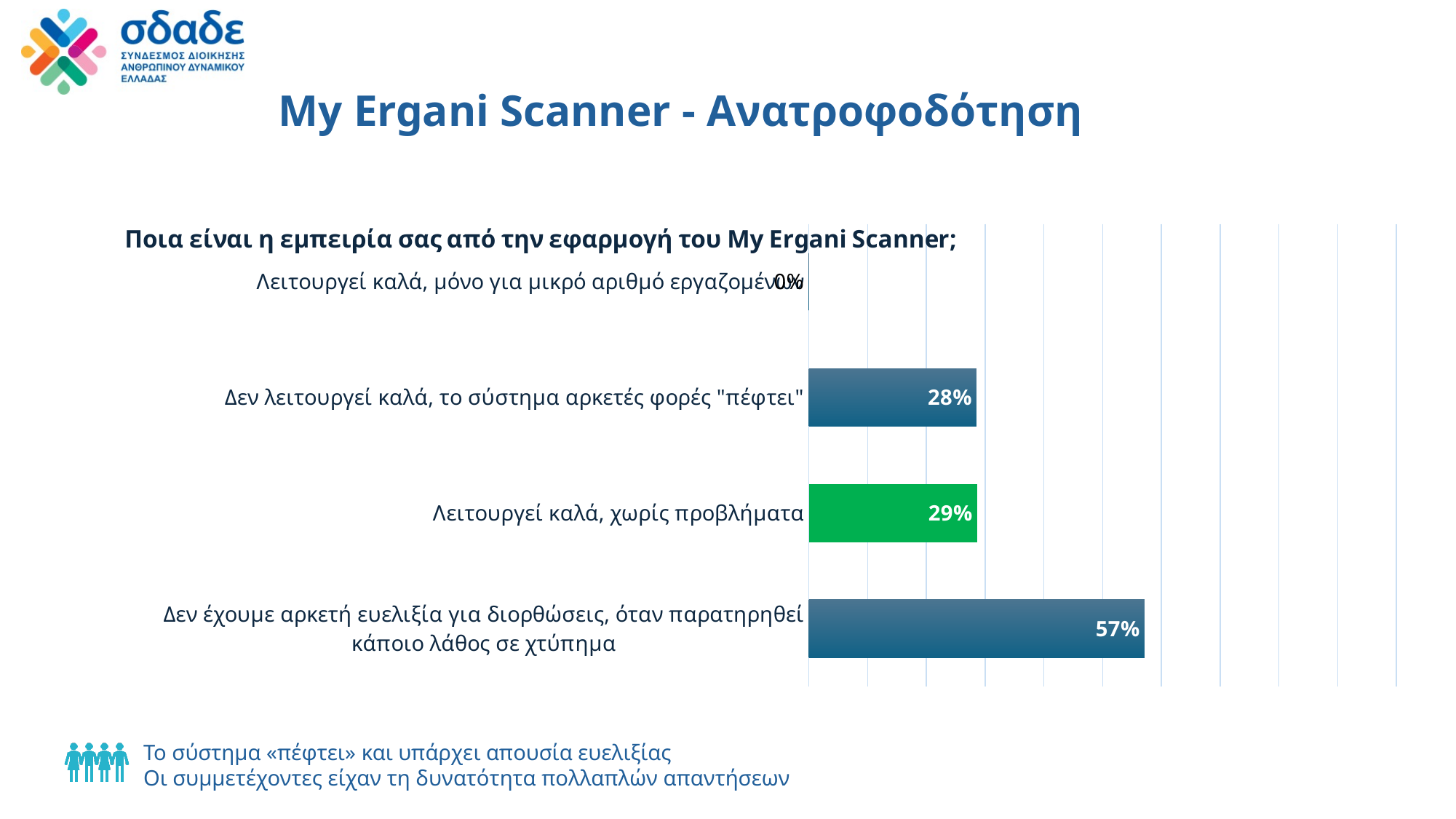
Which category has the lowest value? Λειτουργεί καλά, μόνο για μικρό αριθμό εργαζομένων How many categories does the chart show? 4 What type of chart is shown on the slide? Bar chart What is the value for "Δεν έχουμε αρκετή ευελιξία για διορθώσεις, όταν παρατηρηθεί κάποιο λάθος σε χτύπημα"? 57% Which category has the highest value? Δεν έχουμε αρκετή ευελιξία για διορθώσεις, όταν παρατηρηθεί κάποιο λάθος σε χτύπημα What is the value for "Λειτουργεί καλά, μόνο για μικρό αριθμό εργαζομένων"? 0% What is the difference between the value for "Λειτουργεί καλά, χωρίς προβλήματα" and the value for "Δεν λειτουργεί καλά, το σύστημα αρκετές φορές "πέφτει""? 1% Which is larger: the value for "Δεν έχουμε αρκετή ευελιξία για διορθώσεις, όταν παρατηρηθεί κάποιο λάθος σε χτύπημα" or the value for "Λειτουργεί καλά, χωρίς προβλήματα"? Δεν έχουμε αρκετή ευελιξία για διορθώσεις, όταν παρατηρηθεί κάποιο λάθος σε χτύπημα What is the value for "Δεν λειτουργεί καλά, το σύστημα αρκετές φορές "πέφτει""? 28% What is the value for "Λειτουργεί καλά, χωρίς προβλήματα"? 29% What colour is the bar for "Λειτουργεί καλά, χωρίς προβλήματα"? Green What is the difference between the value for "Δεν έχουμε αρκετή ευελιξία για διορθώσεις, όταν παρατηρηθεί κάποιο λάθος σε χτύπημα" and the value for "Δεν λειτουργεί καλά, το σύστημα αρκετές φορές "πέφτει""? 29%